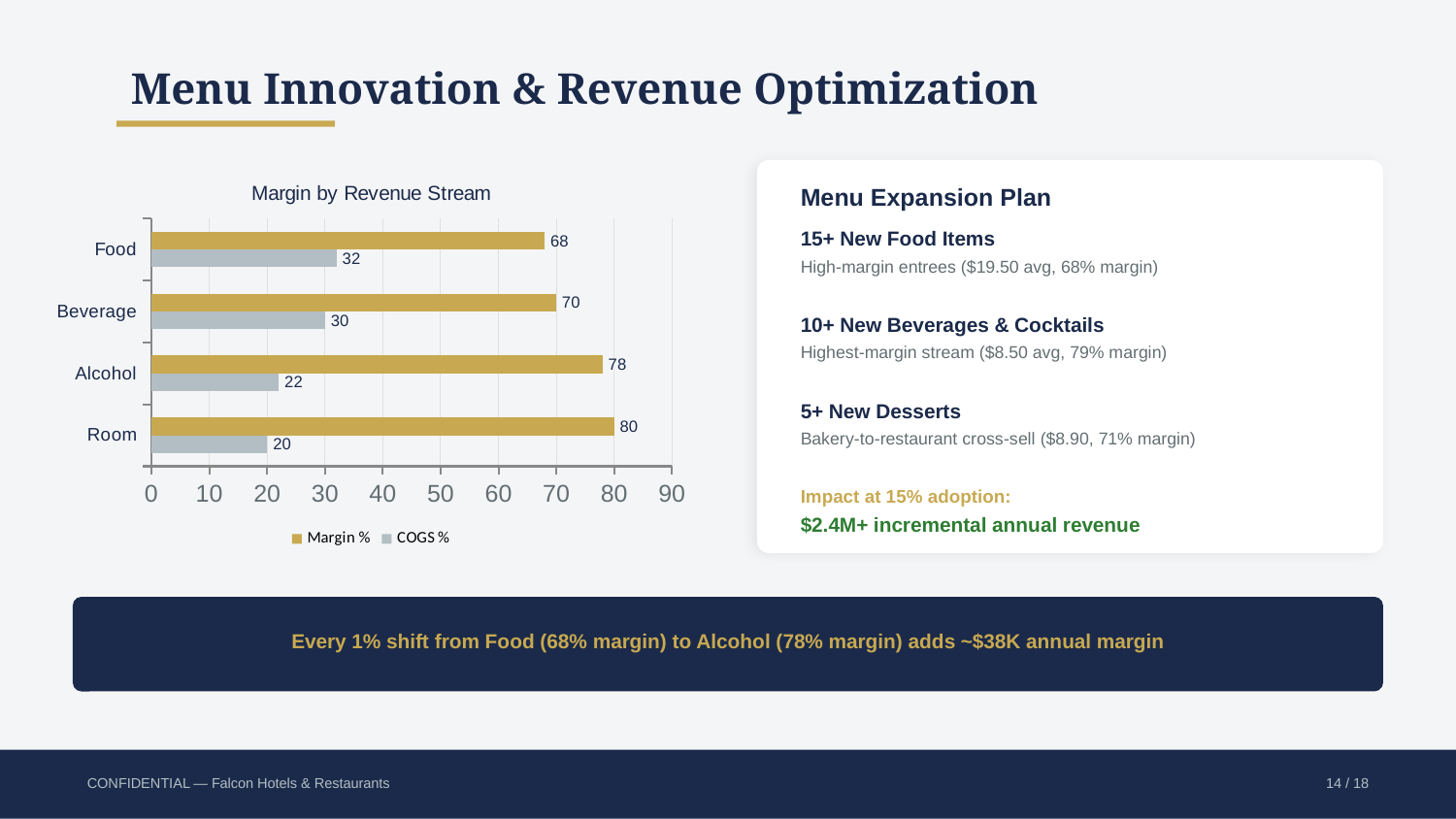
Is the Margin % value for Alcohol greater or less than 70? greater How many series does the chart legend list? 2 What is the title of the chart? Margin by Revenue Stream How many revenue streams are shown on the chart? 4 Which revenue stream has the lowest COGS %? Room Which is larger, the COGS % for Beverage or the COGS % for Alcohol? Beverage Which revenue stream has the highest Margin %? Room What is the difference between the Margin % for Room and the Margin % for Food? 12 What is the COGS % value for Food? 32 What kind of chart is shown on the slide? Bar chart What is the Margin % value for Alcohol? 78 What is the Margin % value for Beverage? 70